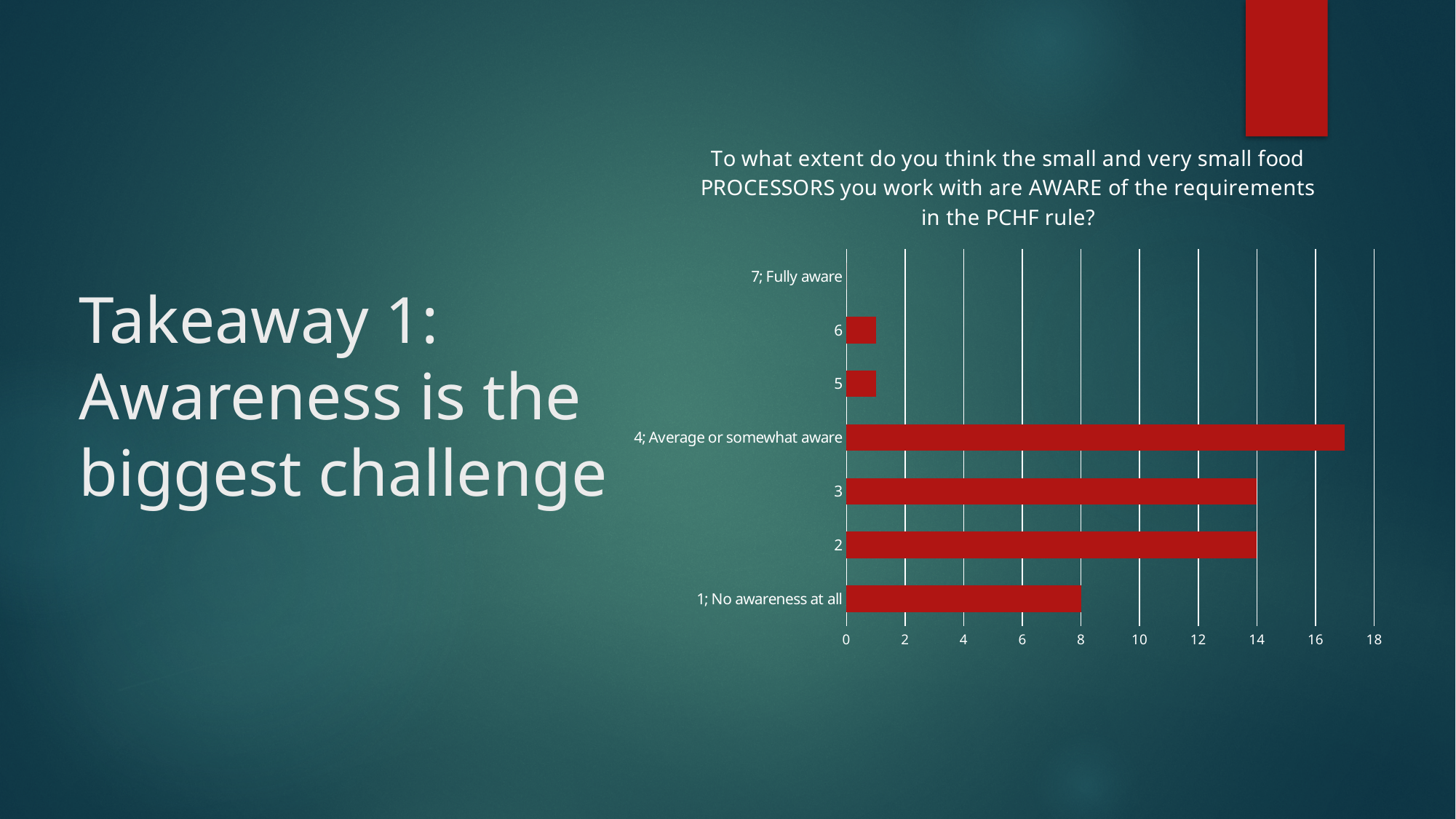
What is the title of the chart? To what extent do you think the small and very small food PROCESSORS you work with are AWARE of the requirements in the PCHF rule? What is the value for category 3? 14 What is the value for "1; No awareness at all"? 8 Is the value for category 6 greater or less than 2? less What is the value for category 2? 14 What kind of chart is shown on the slide? bar chart What is the difference between the value for category 3 and the value for "1; No awareness at all"? 6 Which is larger, the value for "4; Average or somewhat aware" or the value for category 3? 4; Average or somewhat aware Which category has the lowest value? 7; Fully aware Is the value for "4; Average or somewhat aware" greater or less than 16? greater How many categories are shown on the chart? 7 Which category has the highest value? 4; Average or somewhat aware